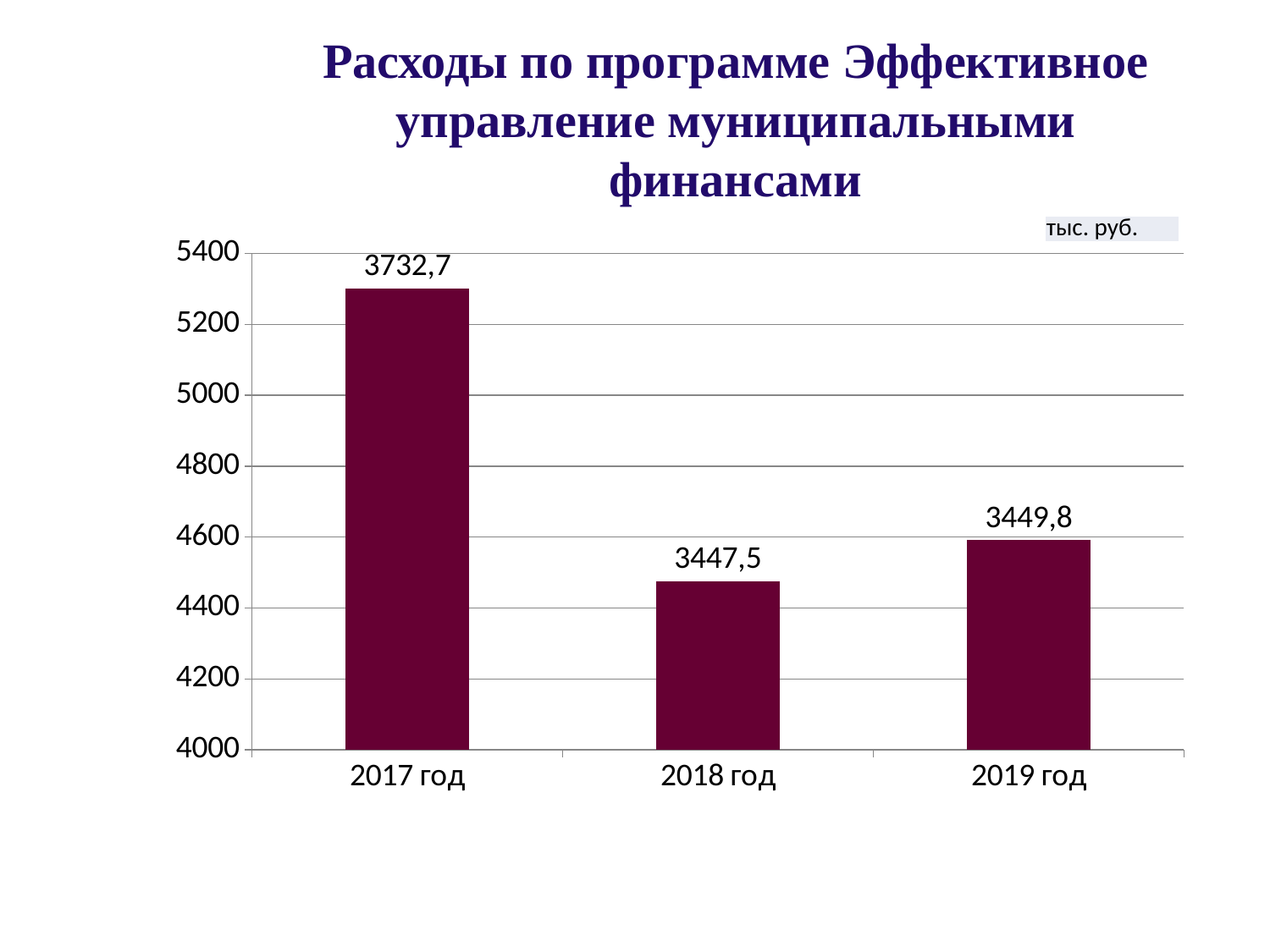
What is the value shown for 2018 год? 3447,5 How do the values change from 2017 год to 2019 год? They fall from 2017 to 2018, then rise slightly in 2019 Which year has the lowest value? 2018 год Which is larger, the value for 2017 год or the value for 2019 год? 2017 год What unit of measurement is indicated on the chart? тыс. руб. What is the value shown for 2017 год? 3732,7 What is the value shown for 2019 год? 3449,8 What is the difference between the values for 2019 год and 2018 год? 2,3 Which year has the highest value? 2017 год What kind of chart is this? Bar chart How many years are shown on the chart? 3 What is the difference between the values for 2017 год and 2018 год? 285,2